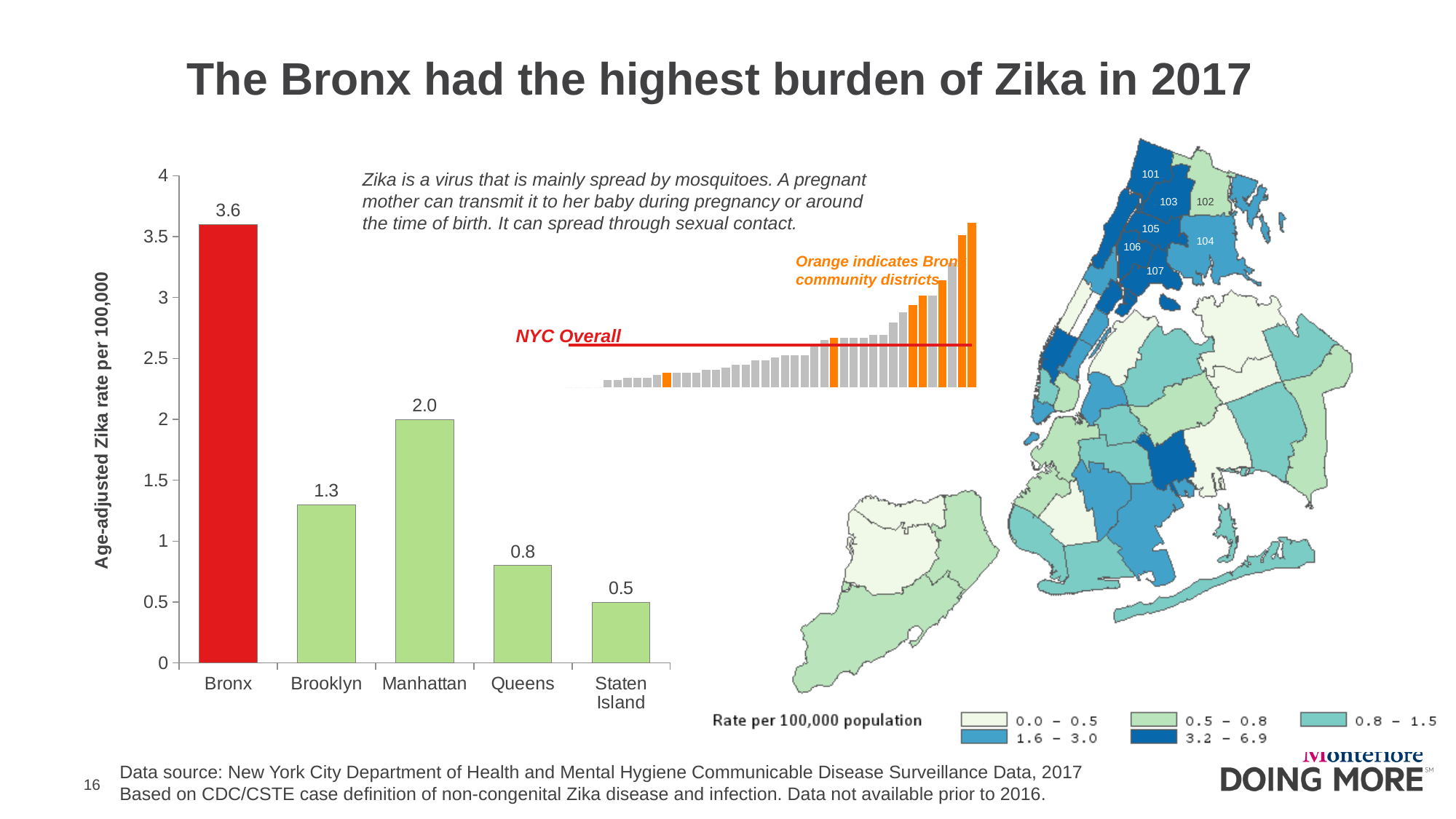
In the bar chart of age-adjusted Zika rate by borough, which is larger, the value for Brooklyn or the value for Queens? Brooklyn In the bar chart of age-adjusted Zika rate by borough, what is the value for Staten Island? 0.5 In the bar chart of age-adjusted Zika rate by borough, which borough has the highest rate? Bronx What kind of chart is the large chart on the left showing age-adjusted Zika rate by borough? Bar chart In the bar chart of age-adjusted Zika rate by borough, what is the difference between the Bronx and Brooklyn values? 2.3 In the bar chart of age-adjusted Zika rate by borough, what is the value for Manhattan? 2.0 How many boroughs are shown in the bar chart of age-adjusted Zika rate by borough? 5 In the bar chart of age-adjusted Zika rate by borough, is the value for Manhattan greater or less than 1.5? greater In the bar chart of age-adjusted Zika rate by borough, which borough has the lowest rate? Staten Island In the bar chart of age-adjusted Zika rate by borough, which bar is coloured red? Bronx In the bar chart of age-adjusted Zika rate by borough, what is the difference between the Manhattan and Queens values? 1.2 In the bar chart of age-adjusted Zika rate by borough, what is the value for the Bronx? 3.6